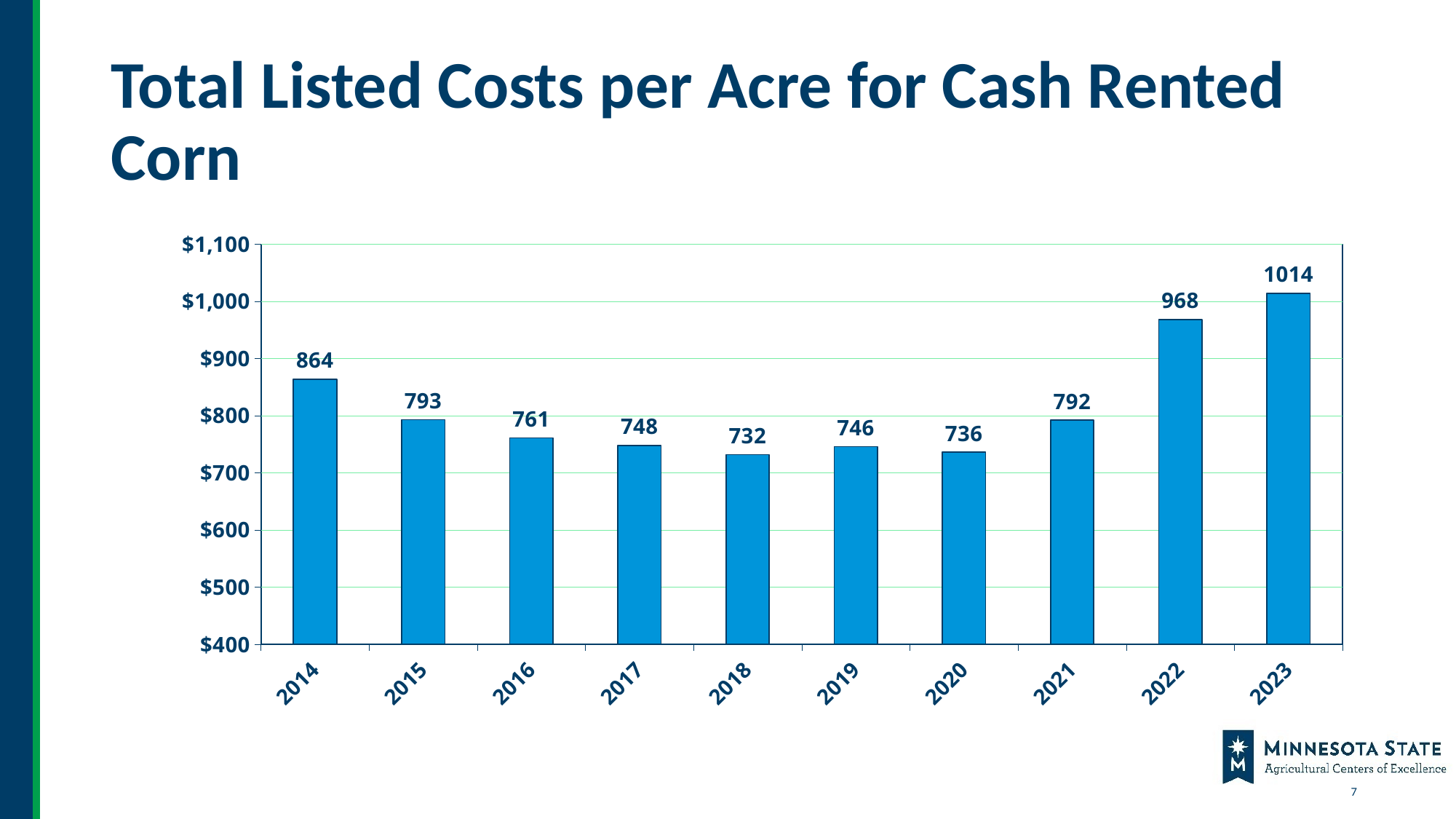
What is the total listed cost per acre for cash rented corn in 2014? 864 What is the difference between the 2023 value and the 2022 value? 46 What kind of chart is shown on the slide? bar chart How many years are shown on the x axis? 10 What is the value shown for 2022? 968 Do the values rise or fall from 2021 to 2023? rise Which year has the highest total listed cost per acre? 2023 Which year has the lowest total listed cost per acre? 2018 Is the value for 2021 greater or less than $800? less What is the difference between the 2014 value and the 2015 value? 71 Which is larger, the value for 2019 or the value for 2020? 2019 What is the value shown for 2018? 732